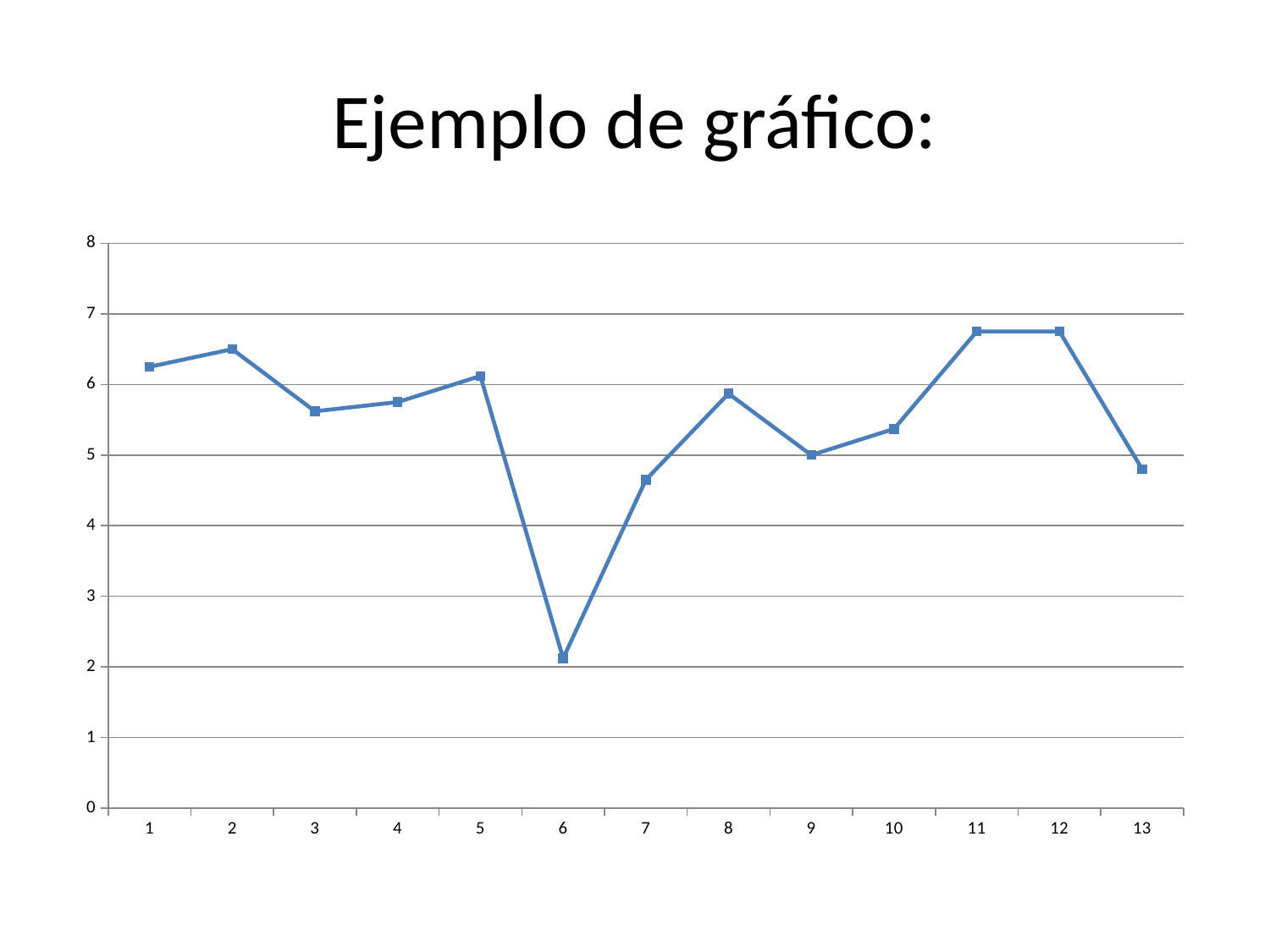
Which has the larger value, category 6 or category 7? 7 What is the title of the slide containing the chart? Ejemplo de gráfico: Does the line rise or fall from category 5 to category 6? fall Is the value for category 11 greater or less than 6? greater Which has the larger value, category 8 or category 9? 8 What kind of chart is shown on the slide? line chart Is the value for category 13 greater or less than 5? less Which category has the lowest value on the line chart? 6 Is the value for category 6 greater or less than 3? less Which has the larger value, category 2 or category 3? 2 How many points are plotted on the line chart? 13